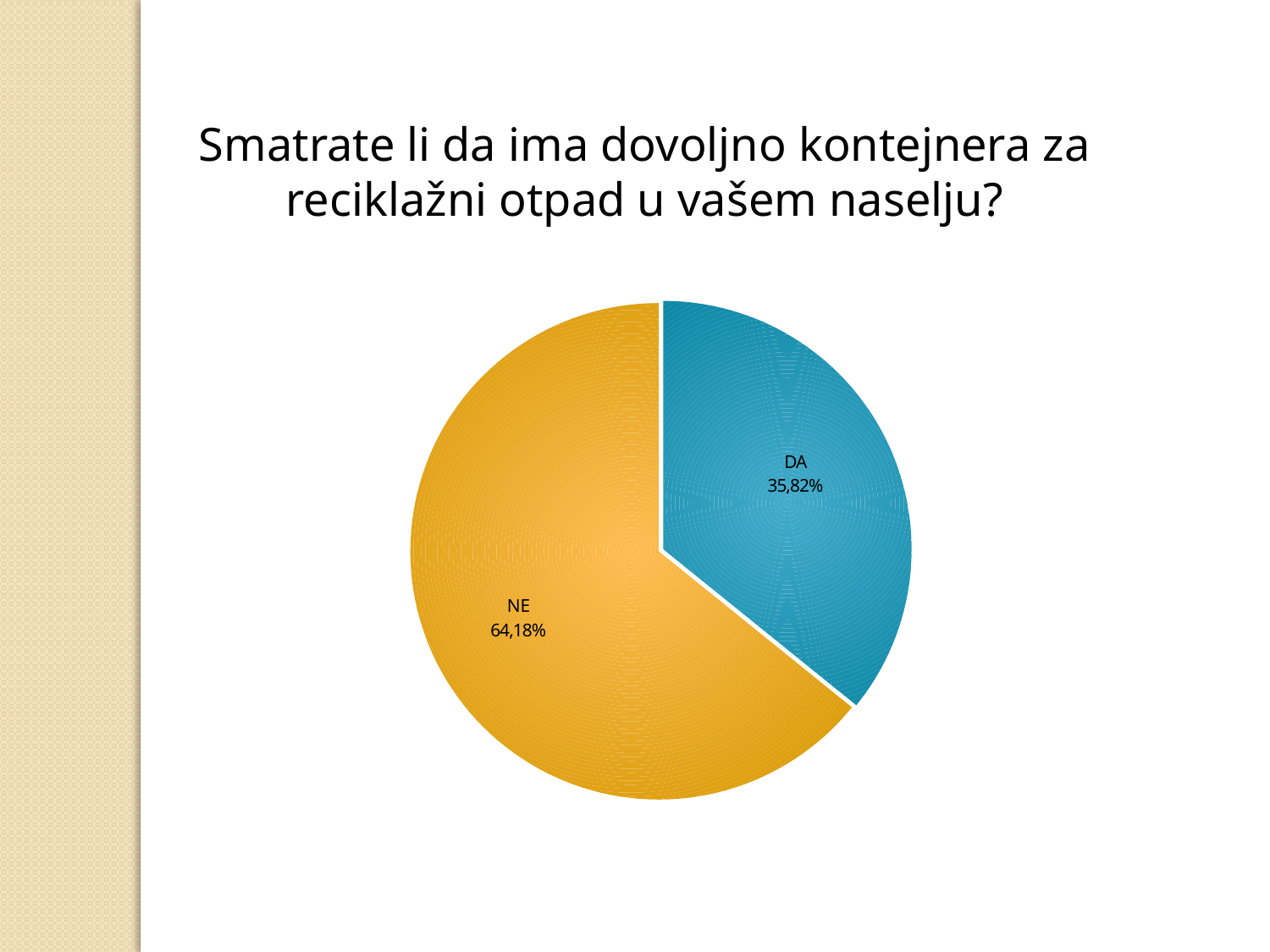
What colour is the NE slice? orange What share of the pie does the DA slice represent? 35,82% Which slice is the largest? NE What share of the pie does the NE slice represent? 64,18% What is the total of the two slices shown? 100% How many slices does the pie chart have? 2 What is the title of the chart? Smatrate li da ima dovoljno kontejnera za reciklažni otpad u vašem naselju? Which slice is the smallest? DA What kind of chart is shown on the slide? pie chart Which is larger, the DA slice or the NE slice? NE What is the difference in percentage points between the NE slice and the DA slice? 28,36%